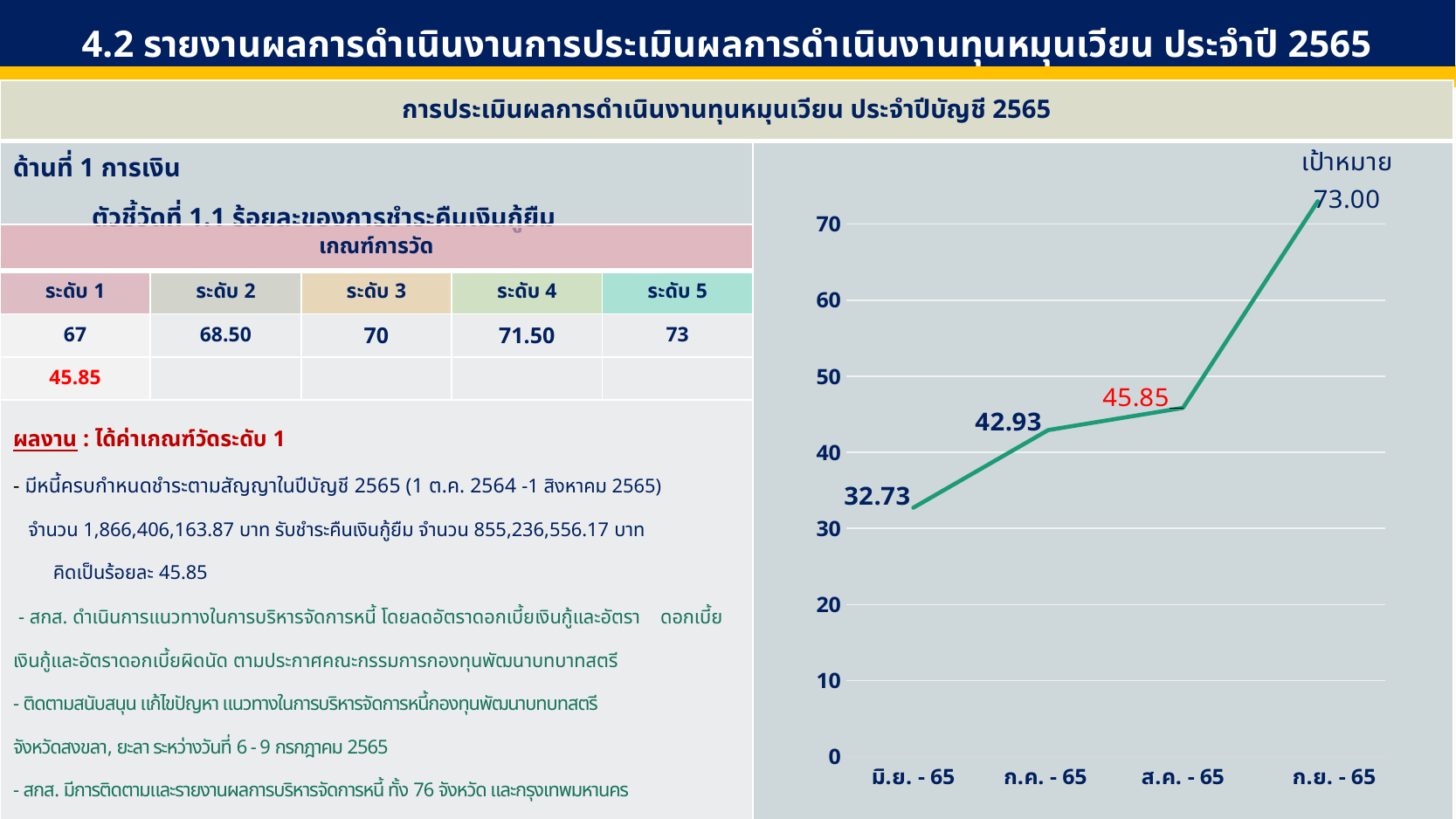
What is the value plotted for มิ.ย. - 65? 32.73 Do the plotted values rise or fall from มิ.ย. - 65 to ก.ย. - 65? rise What is the value plotted for ก.ย. - 65? 73.00 How many data points are plotted on the line chart? 4 Which is larger, the value for ส.ค. - 65 or the value for ก.ค. - 65? ส.ค. - 65 What type of chart is shown on the right side of the slide? line chart What is the difference between the values for ก.ย. - 65 and ส.ค. - 65? 27.15 What is the value plotted for ก.ค. - 65? 42.93 Which month on the x axis has the lowest plotted value? มิ.ย. - 65 What is the value plotted for ส.ค. - 65? 45.85 Which month on the x axis has the highest plotted value? ก.ย. - 65 What is the difference between the values for ก.ค. - 65 and มิ.ย. - 65? 10.20